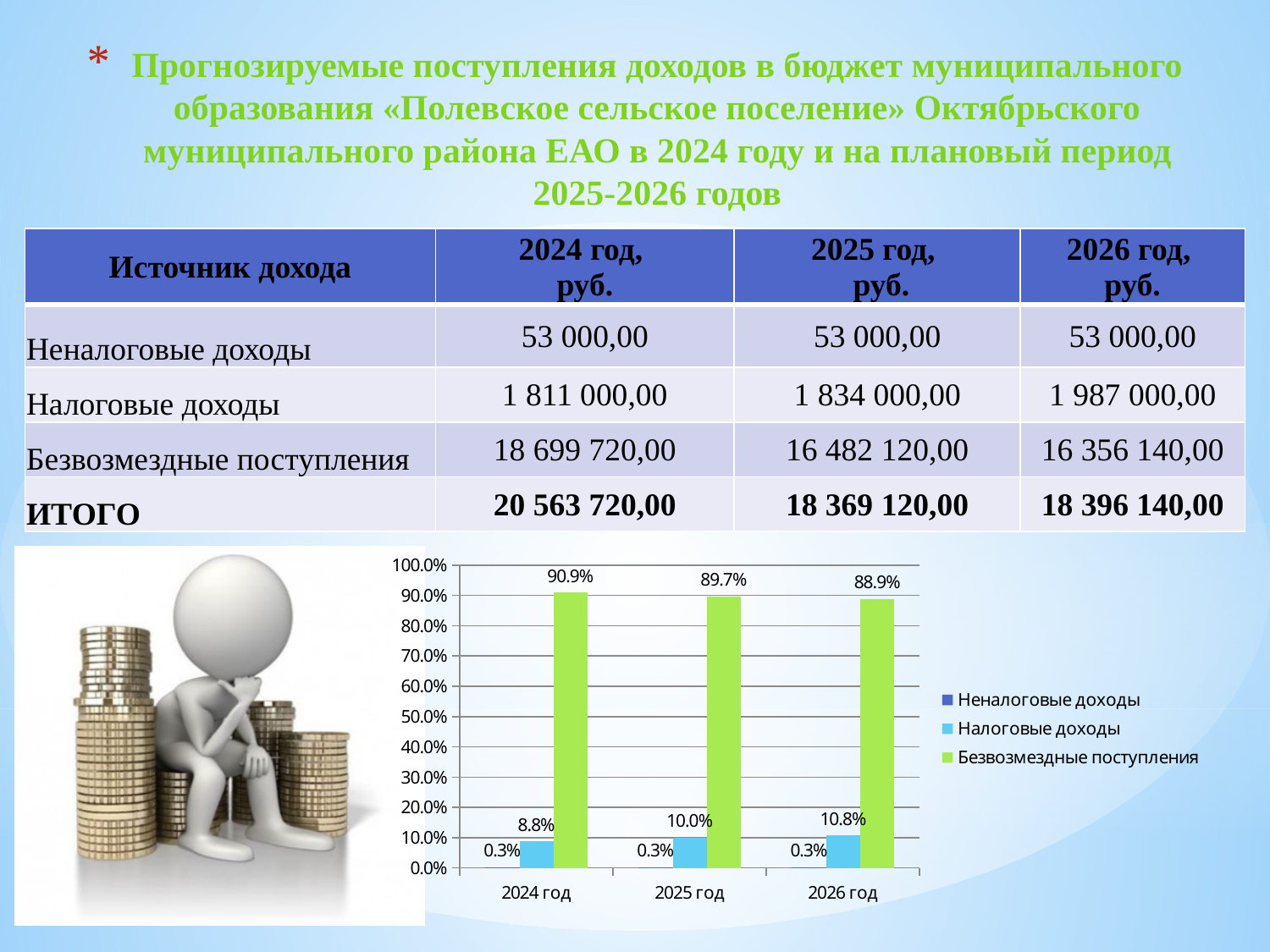
What is the difference between the Безвозмездные поступления values for 2024 год and 2026 год on the chart? 2.0% Does the value for Безвозмездные поступления rise or fall from 2024 год to 2026 год on the chart? fall In which year is the value for Безвозмездные поступления the lowest on the chart? 2026 год What is the value for Налоговые доходы in 2025 год on the chart? 10.0% What is the value for Налоговые доходы in 2026 год on the chart? 10.8% Which series is shown in green on the chart? Безвозмездные поступления In which year is the value for Налоговые доходы the highest on the chart? 2026 год How many year categories are shown on the x axis of the chart? 3 What is the value for Безвозмездные поступления in 2024 год on the chart? 90.9% What kind of chart is shown on the slide? bar chart How many series does the chart legend list? 3 What is the value for Неналоговые доходы in 2026 год on the chart? 0.3%